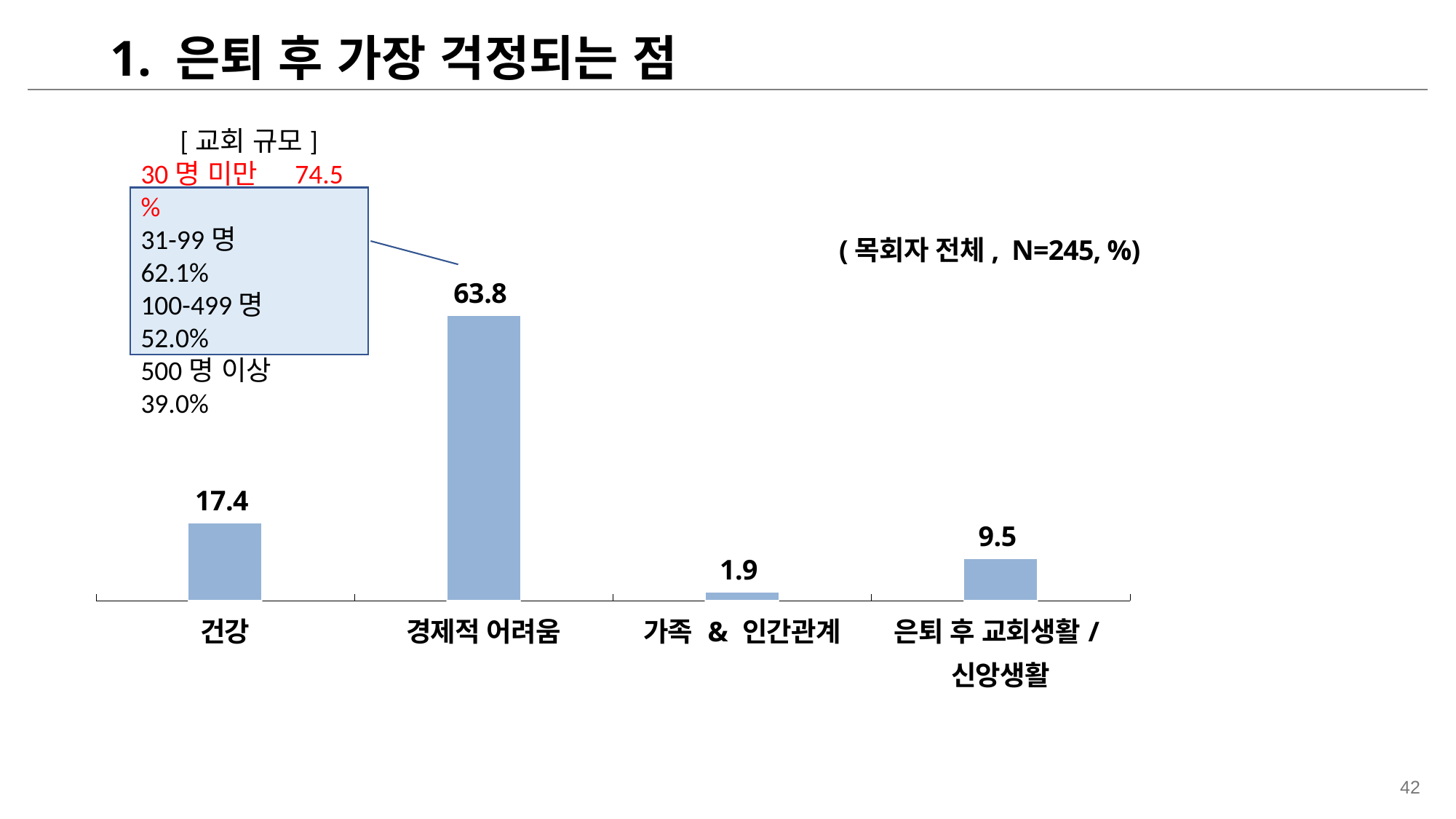
What is the difference between the values for 건강 and 은퇴 후 교회생활 / 신앙생활? 7.9 Which category has the highest value? 경제적 어려움 What is the sample size (N) stated on the slide for the chart? 245 Which category has the lowest value? 가족 & 인간관계 How many categories are shown in the chart? 4 What is the value for 은퇴 후 교회생활 / 신앙생활? 9.5 What is the value for 건강? 17.4 What is the value for 경제적 어려움? 63.8 What kind of chart is shown on the slide? bar chart What is the value for 가족 & 인간관계? 1.9 What is the difference between the values for 경제적 어려움 and 건강? 46.4 Which is larger, the value for 건강 or the value for 은퇴 후 교회생활 / 신앙생활? 건강